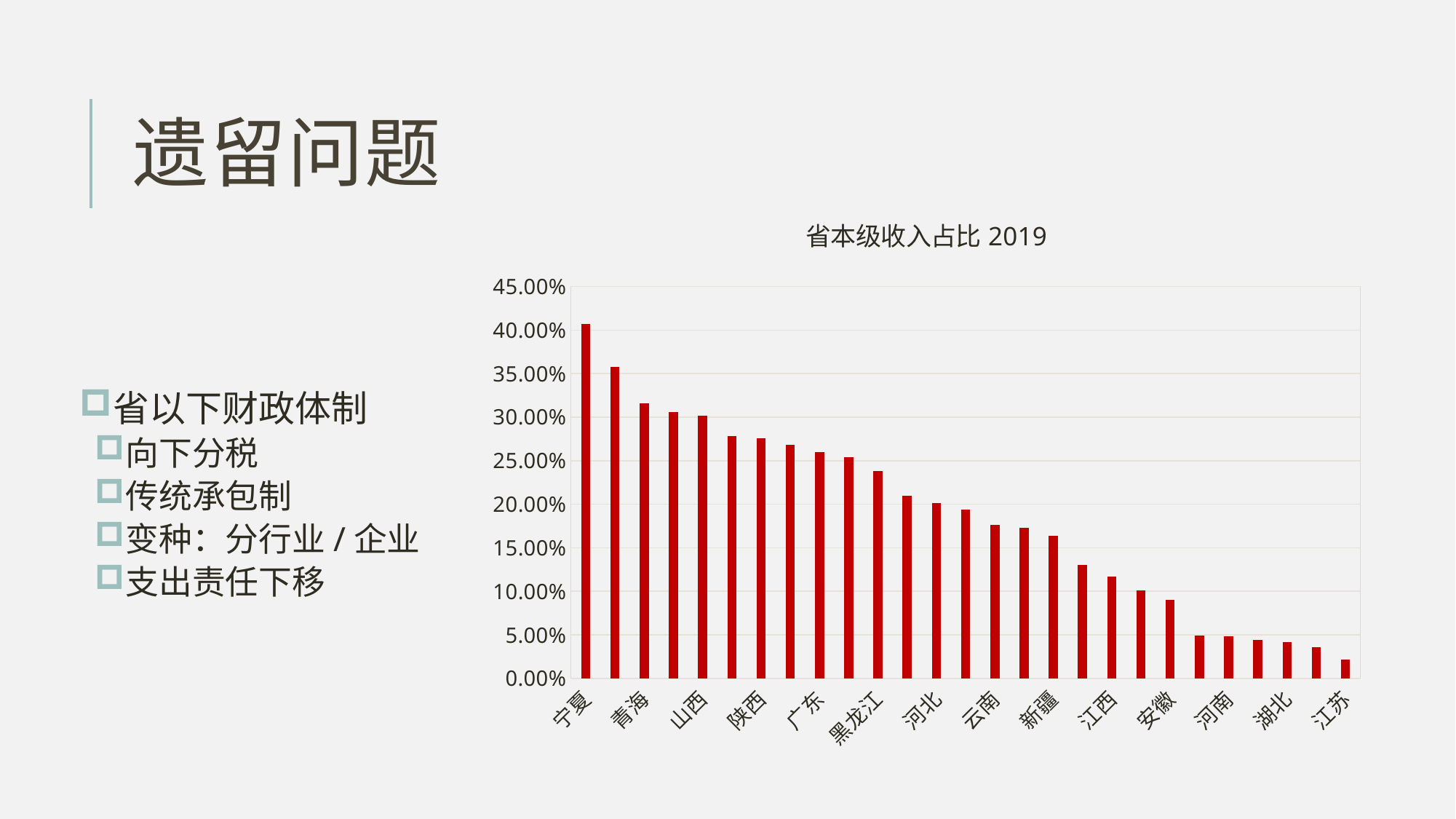
Is the value for 云南 greater or less than 20.00%? less What is the title of the chart? 省本级收入占比 2019 Is the value for 青海 greater or less than 30.00%? greater Is the value for 陕西 greater or less than 25.00%? greater Which is larger, the value for 宁夏 or the value for 江苏? 宁夏 What kind of chart is shown on the slide? bar chart Which labelled province has the highest value in the chart? 宁夏 Do the values rise or fall from left to right along the x axis? fall Which labelled province has the lowest value in the chart? 江苏